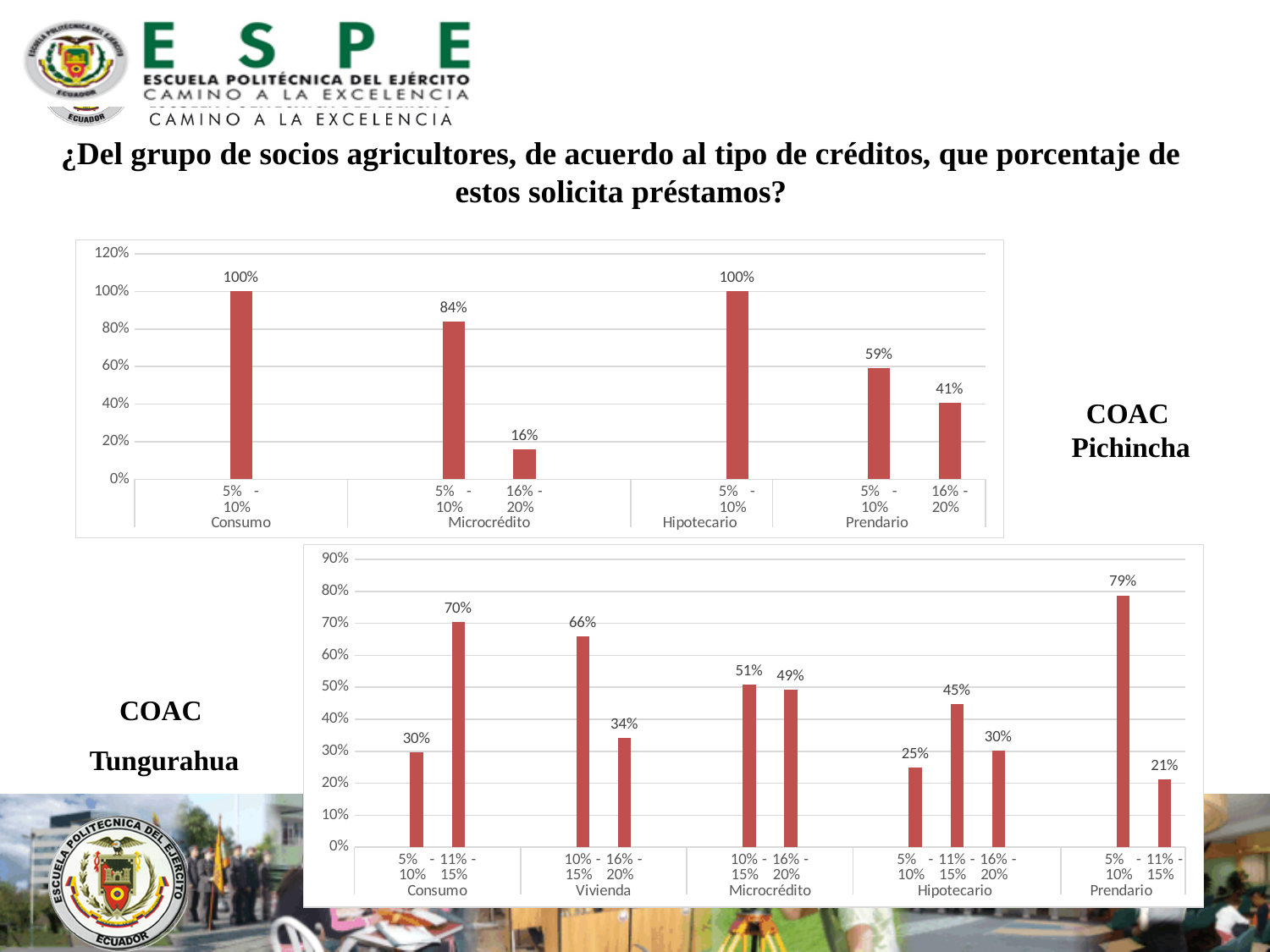
In the COAC Pichincha chart, what is the difference between the 5% - 10% and 16% - 20% bars under Prendario? 18% In the COAC Pichincha chart, what is the value for the 5% - 10% bar under Microcrédito? 84% In the COAC Pichincha chart, what is the value for the 16% - 20% bar under Prendario? 41% In the COAC Tungurahua chart, which is larger: the 10% - 15% bar under Vivienda or the 10% - 15% bar under Microcrédito? 10% - 15% Vivienda How many bars are plotted in the COAC Tungurahua chart? 11 How many bars are plotted in the COAC Pichincha chart? 6 In the COAC Tungurahua chart, what is the value for the 16% - 20% bar under Hipotecario? 30% What type of chart is the COAC Tungurahua chart? Bar chart In the COAC Tungurahua chart, what is the difference between the 5% - 10% and 11% - 15% bars under Prendario? 58% In the COAC Tungurahua chart, what is the value for the 11% - 15% bar under Consumo? 70% In the COAC Tungurahua chart, which bar has the highest value? 5% - 10% Prendario In the COAC Pichincha chart, which bar has the lowest value? 16% - 20% Microcrédito